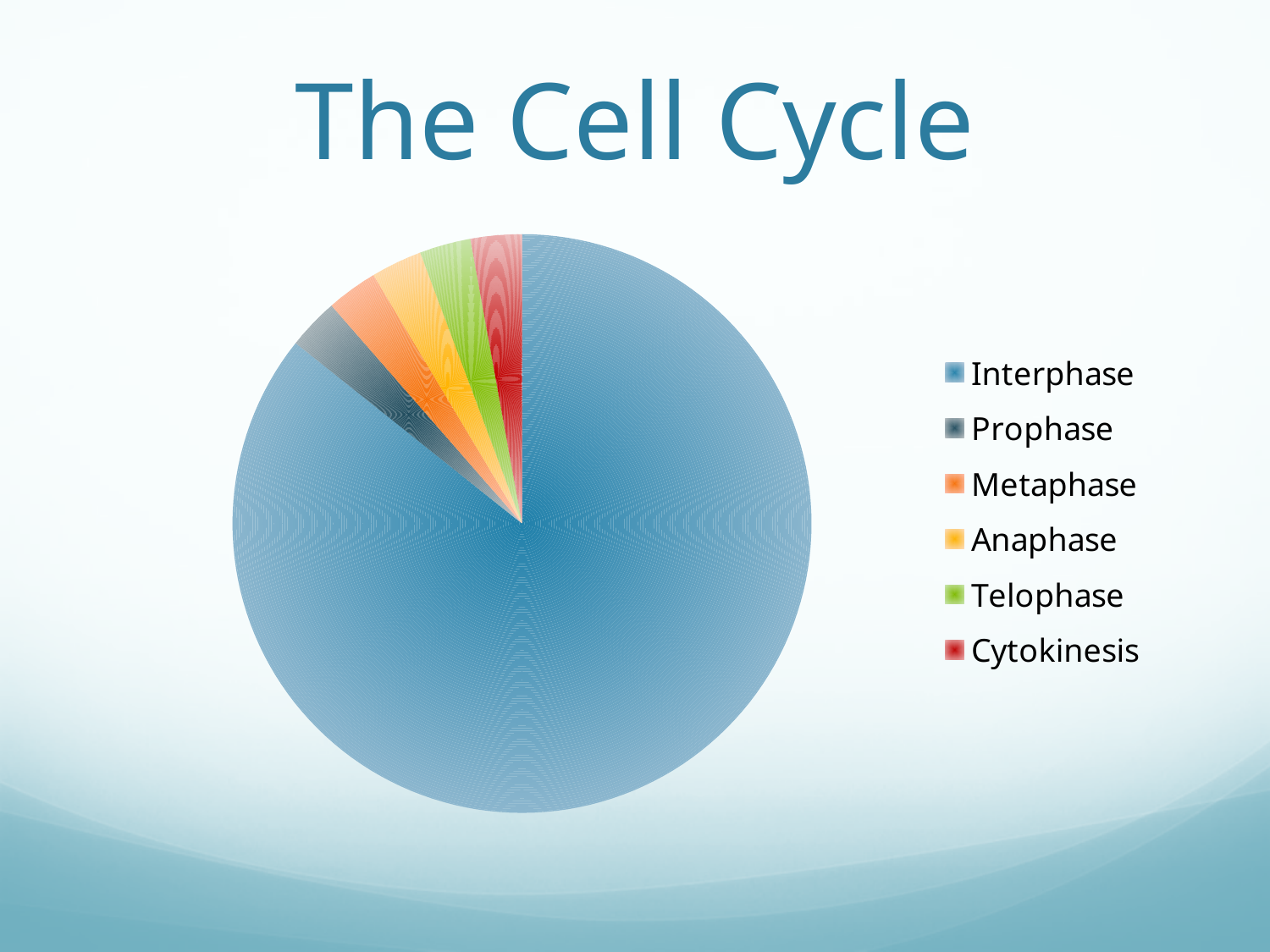
What is the title of the slide containing the pie chart? The Cell Cycle Which slice is larger, Metaphase or Interphase? Interphase Which category has the largest slice in the pie chart? Interphase How many categories does the pie chart's legend list? 6 Which category is shown in blue in the pie chart? Interphase Which slice is larger, Interphase or Prophase? Interphase What kind of chart is shown on the slide? pie chart Which category is listed last in the pie chart's legend? Cytokinesis